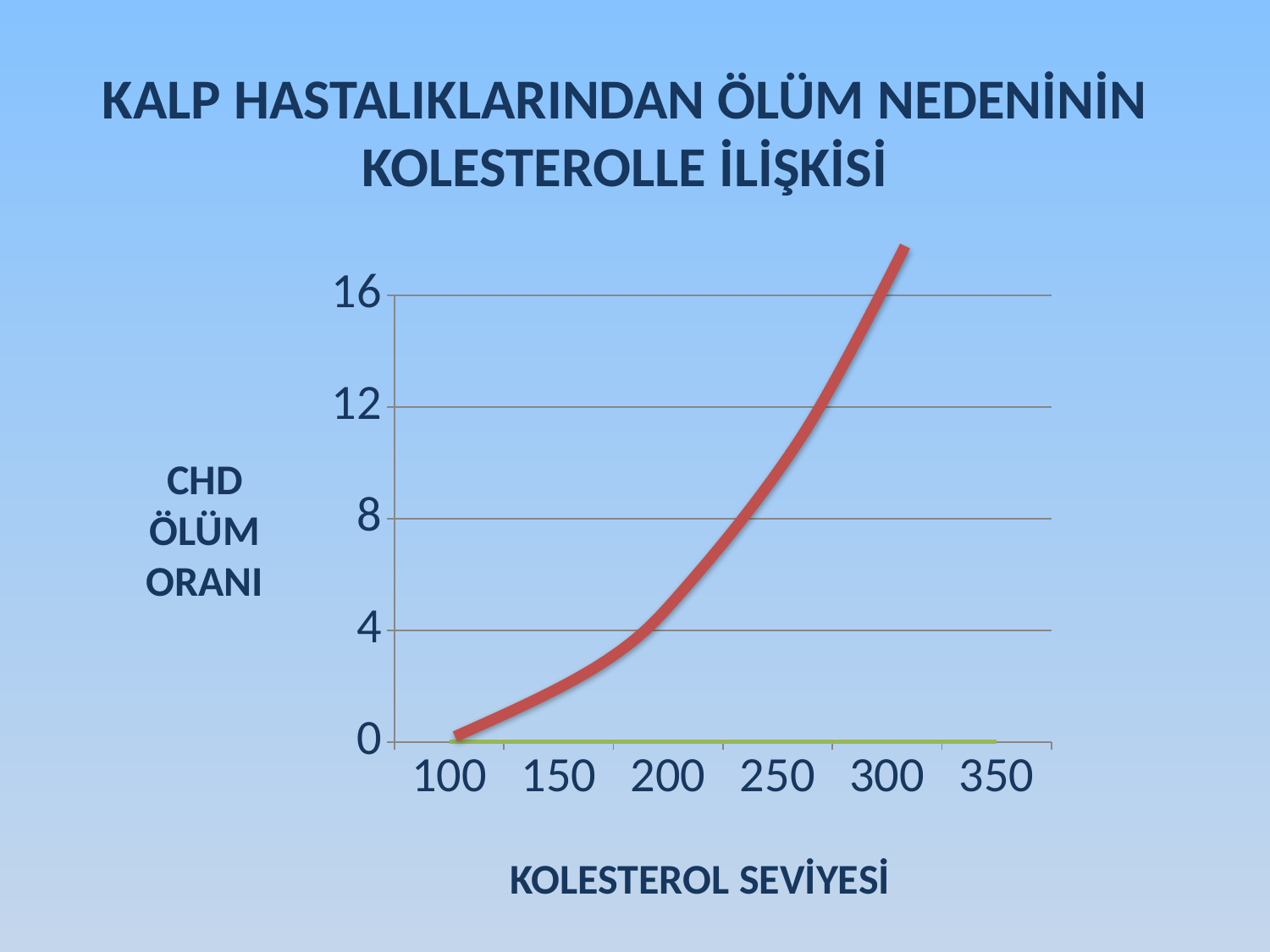
Does the CHD death rate rise or fall as cholesterol level increases along the x axis? rises What is the label of the y axis? CHD ÖLÜM ORANI At which labelled cholesterol level does the red line reach its highest value? 300 At which labelled cholesterol level is the red line at its lowest value? 100 Is the value of the red line at cholesterol level 100 greater or less than 4? less What kind of chart is shown on the slide? line chart Is the value of the red line at cholesterol level 200 greater or less than 8? less What is the label of the x axis? KOLESTEROL SEVİYESİ How many cholesterol level tick labels are shown on the x axis? 6 Is the value of the red line at cholesterol level 150 greater or less than 4? less Which is larger: the red line's value at cholesterol level 250 or at 150? 250